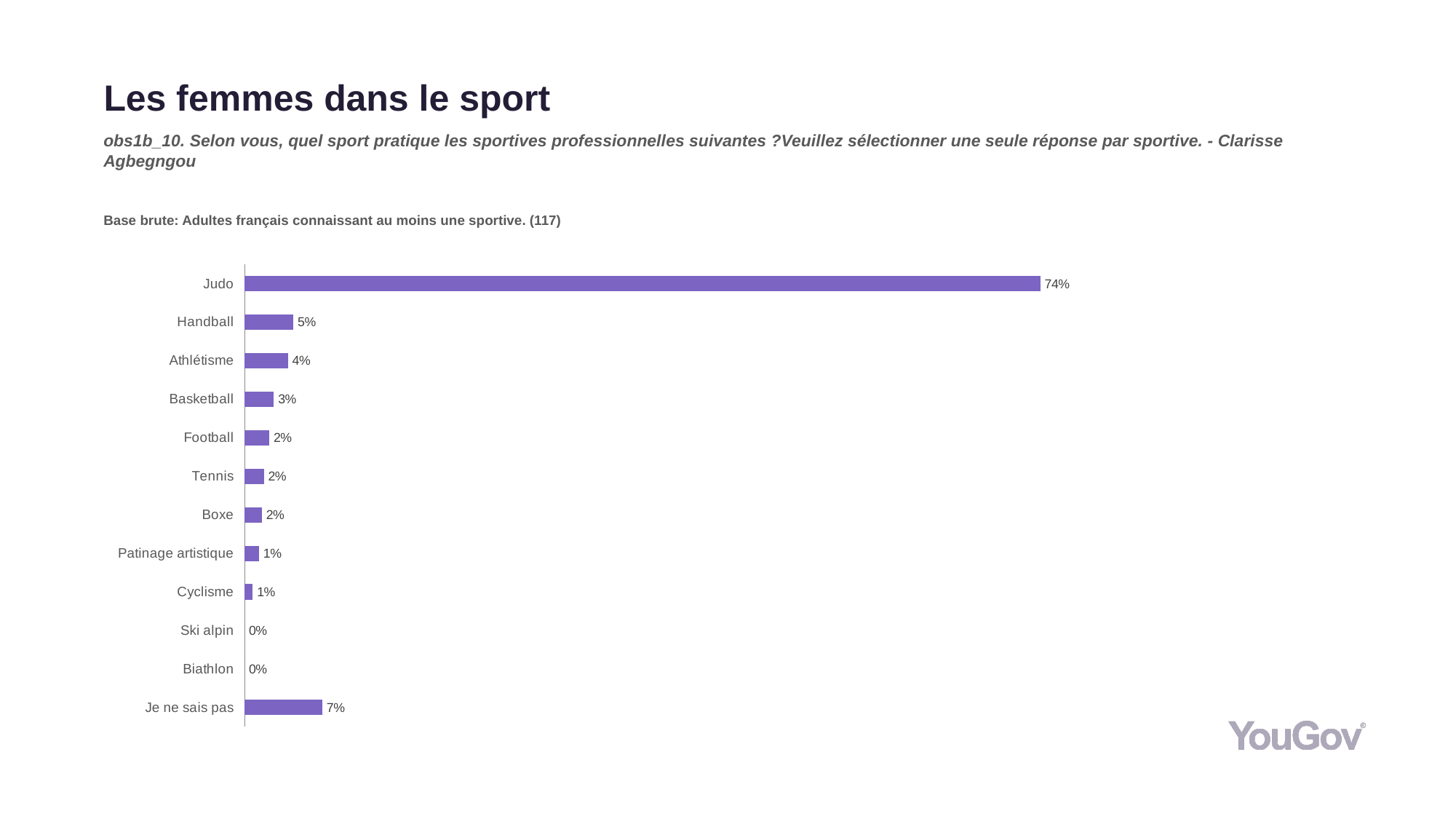
What is the value for Athlétisme? 4% What is the value for Je ne sais pas? 7% How many categories are shown on the chart? 12 What kind of chart is shown on the slide? Bar chart What is the difference between the values for Judo and Handball? 69% Which categories have a value of 0%? Ski alpin and Biathlon Which category has the highest value? Judo What is the value for Cyclisme? 1% What is the value for Judo? 74% Which is larger, the value for Handball or the value for Basketball? Handball What is the difference between the values for Je ne sais pas and Basketball? 4% What is the value for Handball? 5%